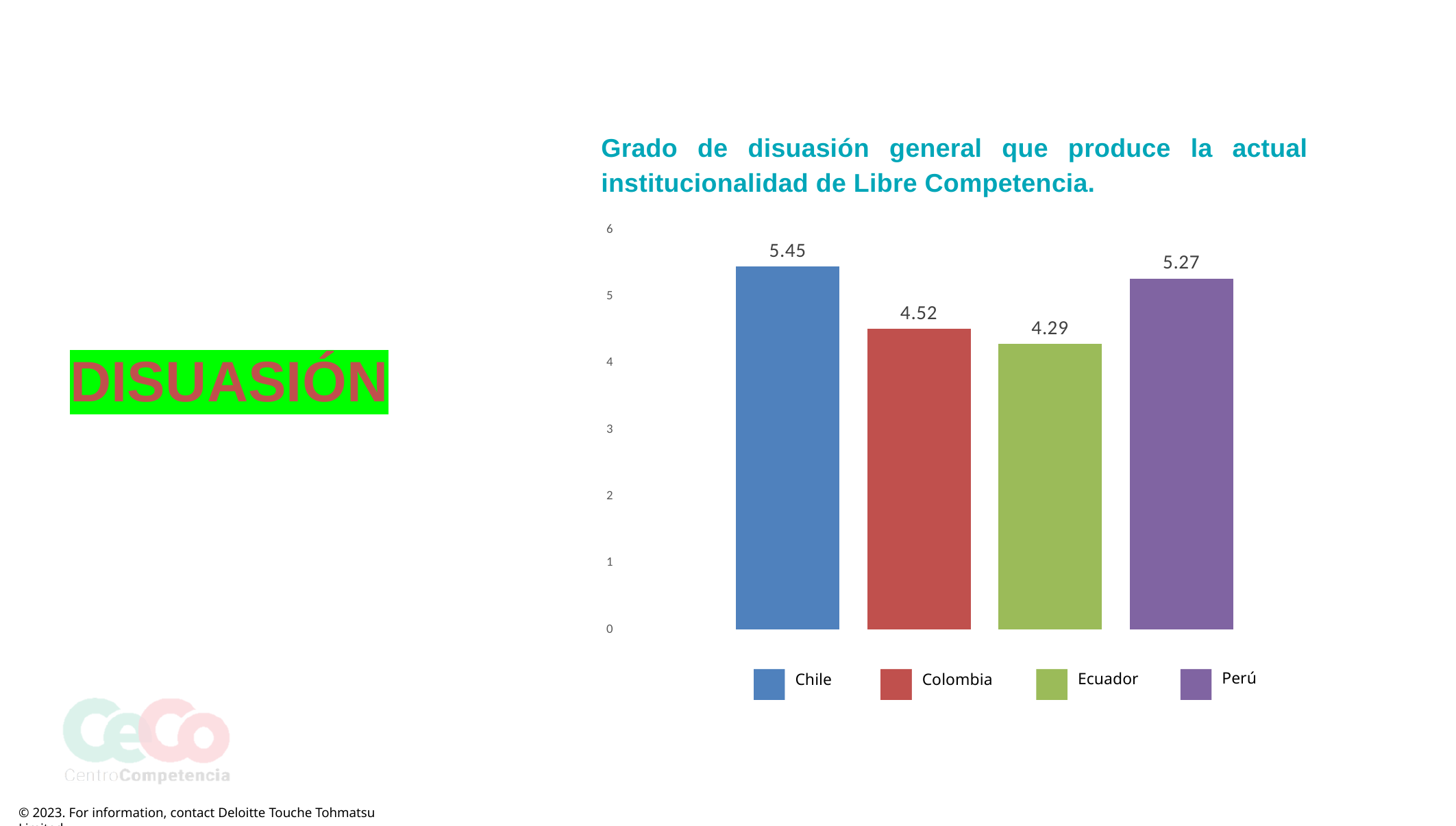
What colour is the bar for Ecuador? green Which country has the highest value? Chile What is the difference between the values for Chile and Ecuador? 1.16 What is the value for Ecuador? 4.29 How many countries are shown in the chart? 4 What is the value for Colombia? 4.52 Which is larger, the value for Colombia or the value for Perú? Perú What is the value for Perú? 5.27 Which country has the lowest value? Ecuador What kind of chart is shown on the slide? bar chart What is the value for Chile? 5.45 Is the value for Colombia greater or less than 5? less